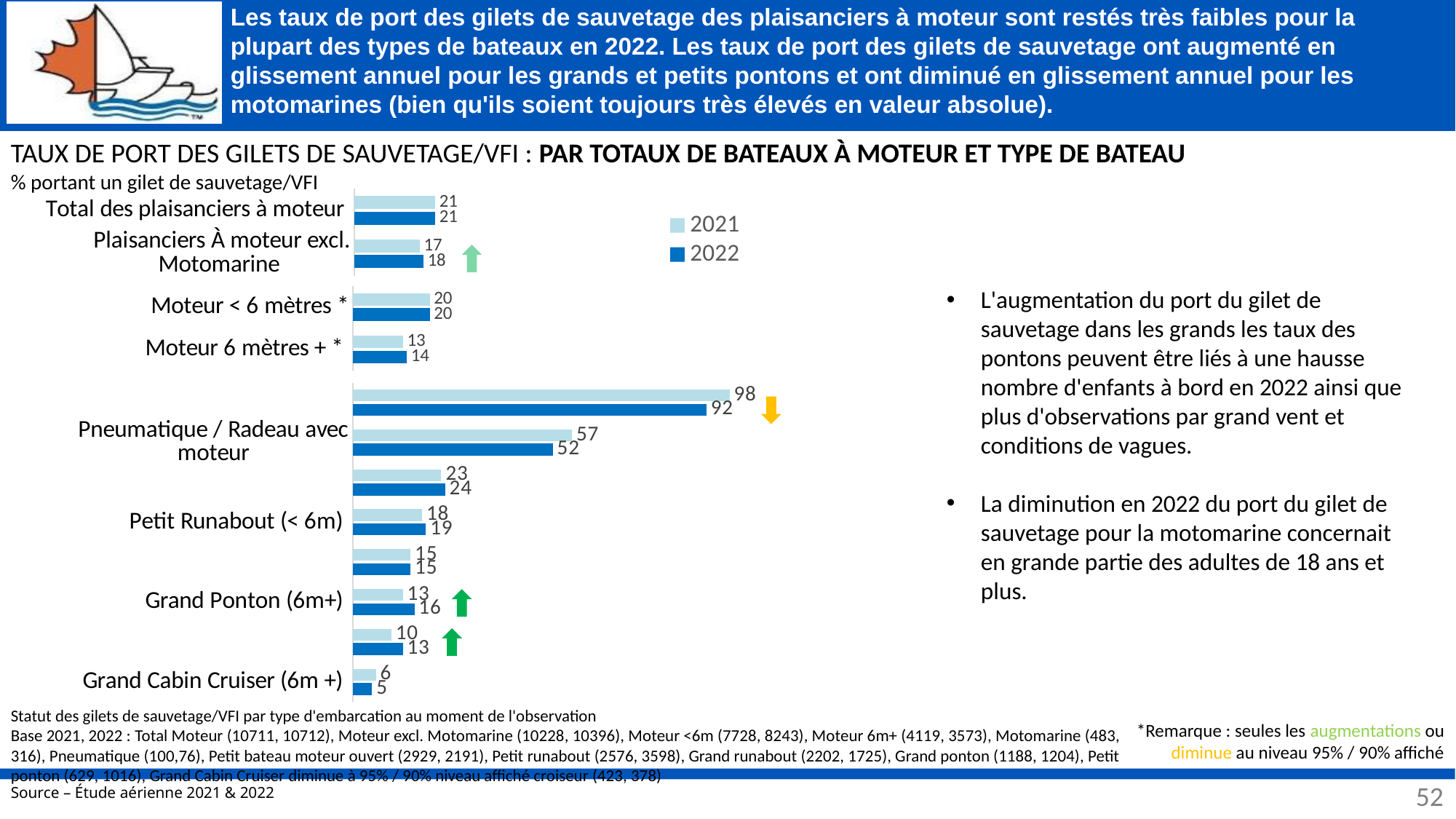
What is the 2022 value for Moteur 6 mètres + *? 14 What is the 2022 value for Pneumatique / Radeau avec moteur? 52 What is the 2022 value for Grand Ponton (6m+)? 16 How many series does the legend list? 2 What kind of chart is shown on the slide? Bar chart What is the 2021 value for Petit Runabout (< 6m)? 18 What is the 2022 value for Total des plaisanciers à moteur? 21 Which category has the lowest 2022 value? Grand Cabin Cruiser (6m +) By how much did the value for Pneumatique / Radeau avec moteur decrease from 2021 to 2022? 5 For Grand Cabin Cruiser (6m +), which year has the higher value, 2021 or 2022? 2021 What is the 2021 value for Plaisanciers À moteur excl. Motomarine? 17 By how much did the value for Grand Ponton (6m+) increase from 2021 to 2022? 3